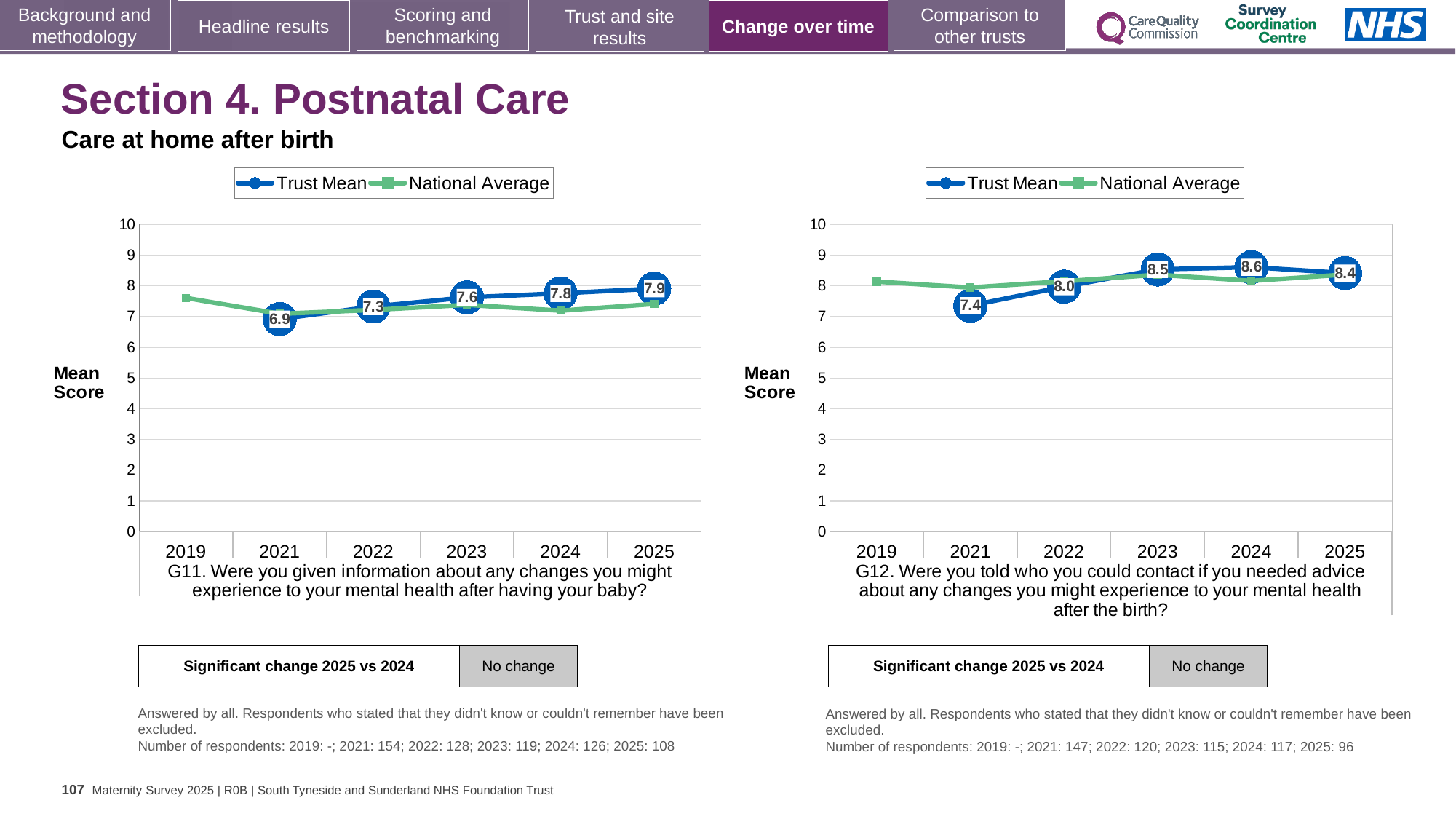
In the G11 chart (left), is the National Average value for 2019 greater or less than 7? greater In the G11 chart (left), which year has the lowest Trust Mean score? 2021 In the G12 chart (right), which is larger: the Trust Mean for 2022 or the Trust Mean for 2023? 2023 In the G12 chart (right), is the National Average value for 2021 greater or less than 9? less In the G12 chart (right), what is the Trust Mean score for 2021? 7.4 In the G12 chart (right), which year has the highest Trust Mean score? 2024 How many series does the legend of the G11 chart (left) list? 2 In the G12 chart (right), what is the difference between the Trust Mean scores for 2024 and 2025? 0.2 In the G11 chart (left), what is the difference between the Trust Mean scores for 2025 and 2021? 1.0 In the G11 chart (left), what is the Trust Mean score for 2025? 7.9 In the G11 chart (left), does the Trust Mean rise or fall from 2021 to 2025? Rise What kind of chart is the G12 chart (right)? Line chart